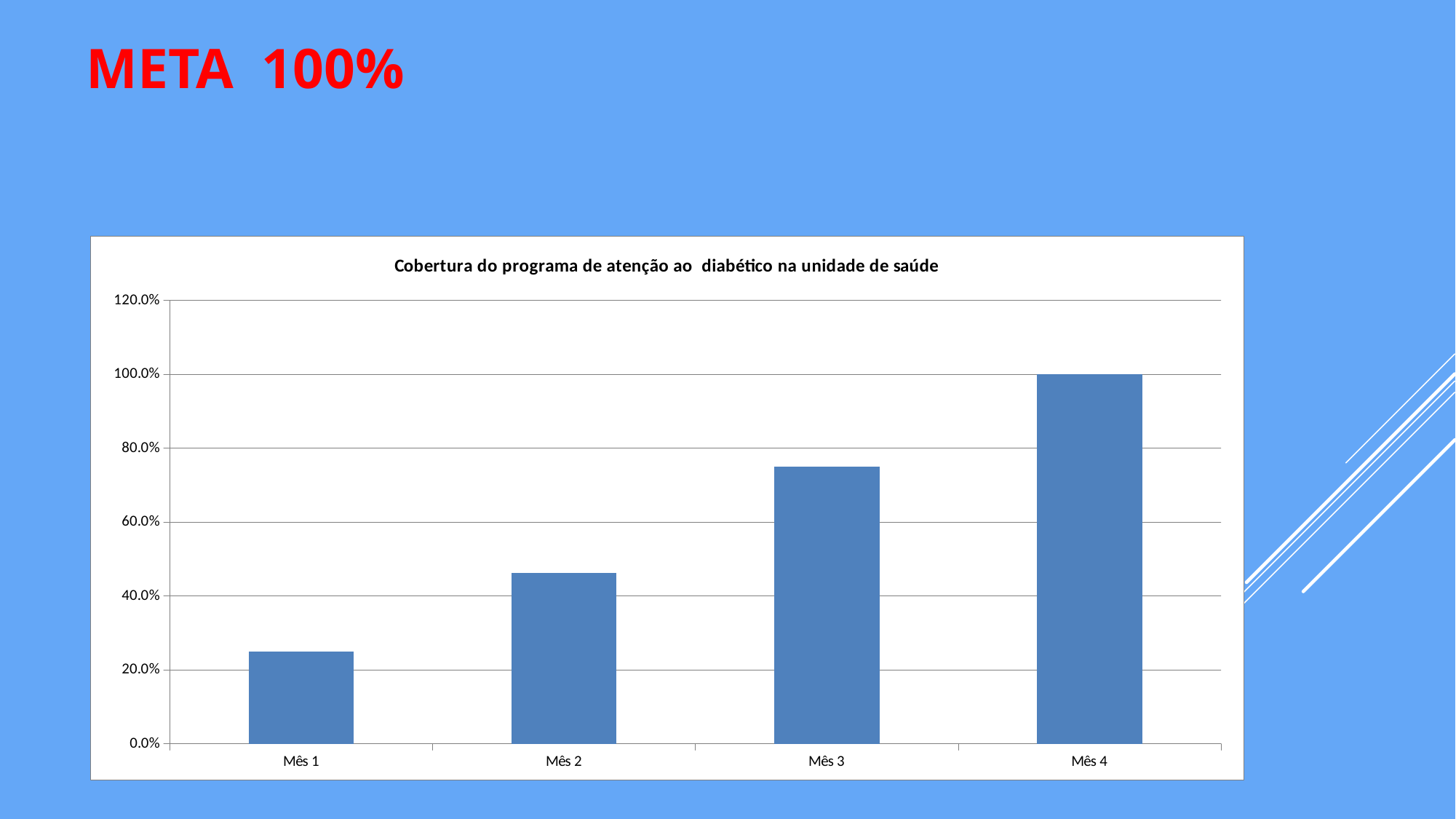
Which month has the highest coverage value? Mês 4 Is the value for Mês 2 greater or less than 40.0%? greater Is the value for Mês 3 greater or less than 80.0%? less What is the coverage value for Mês 4? 100.0% Is the value for Mês 1 greater or less than 40.0%? less What is the title of the chart? Cobertura do programa de atenção ao diabético na unidade de saúde How many months (categories) are plotted on the x axis? 4 Which is larger, the value for Mês 3 or the value for Mês 2? Mês 3 What kind of chart is shown on the slide? bar chart Do the values rise or fall from Mês 1 to Mês 4? rise Which month has the lowest coverage value? Mês 1